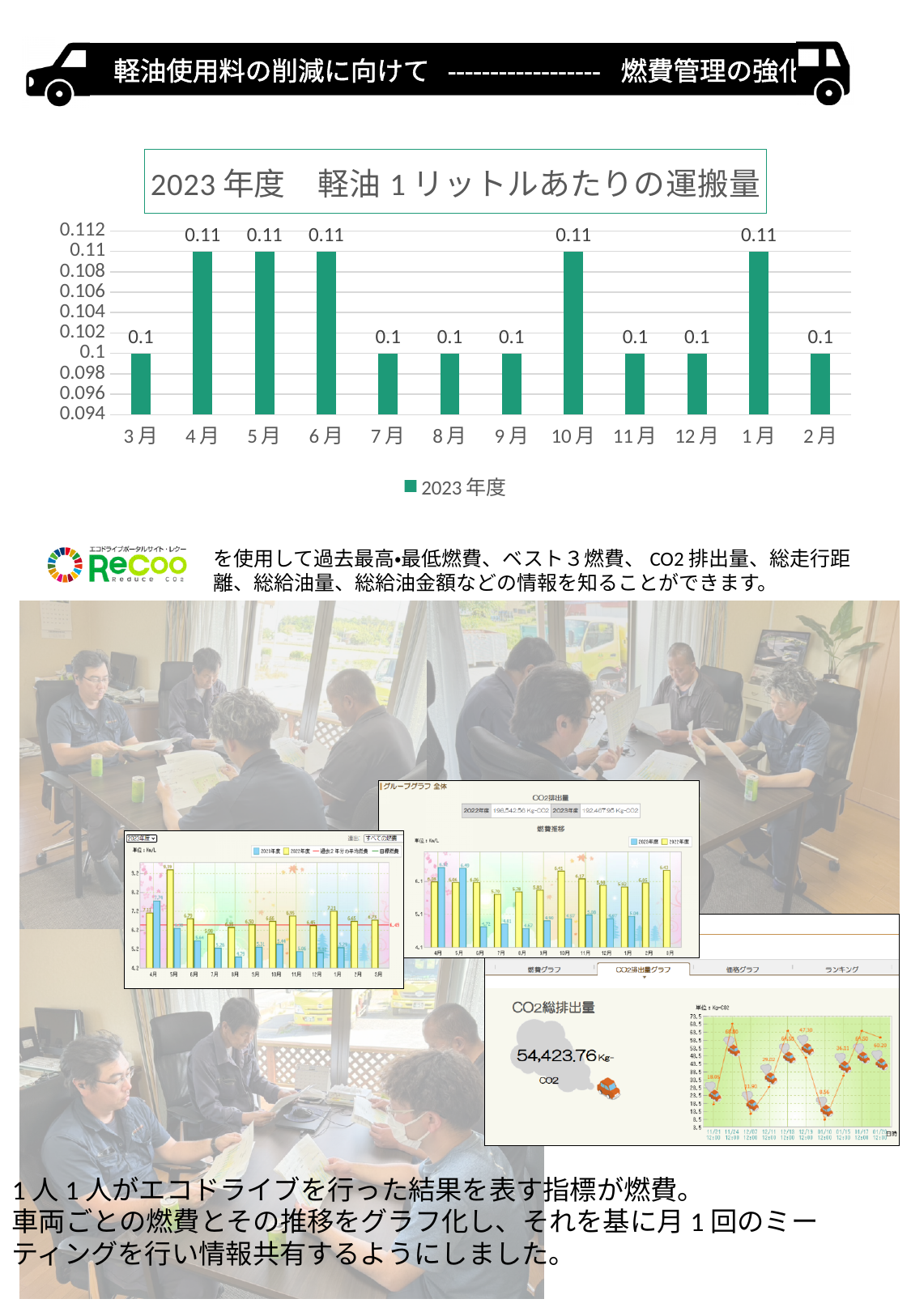
In the chart titled 2023年度 軽油1リットルあたりの運搬量, how many months have a value of 0.11? 5 In the chart titled 2023年度 軽油1リットルあたりの運搬量, what is the value for 12月? 0.1 In the chart titled 2023年度 軽油1リットルあたりの運搬量, what is the value for 4月? 0.11 In the chart titled 2023年度 軽油1リットルあたりの運搬量, which is larger, the value for 10月 or the value for 11月? 10月 In the chart titled 2023年度 軽油1リットルあたりの運搬量, what is the difference between the value for 5月 and the value for 8月? 0.01 In the chart titled 2023年度 軽油1リットルあたりの運搬量, how many series does the legend list? 1 In the chart titled 2023年度 軽油1リットルあたりの運搬量, what is the value for 1月? 0.11 What kind of chart is the one titled 2023年度 軽油1リットルあたりの運搬量? bar chart In the chart titled 2023年度 軽油1リットルあたりの運搬量, how many months are shown on the x axis? 12 In the chart titled 2023年度 軽油1リットルあたりの運搬量, is the value for 6月 greater or less than 0.104? greater In the chart titled 2023年度 軽油1リットルあたりの運搬量, what is the legend entry? 2023年度 In the chart titled 2023年度 軽油1リットルあたりの運搬量, what is the value for 7月? 0.1